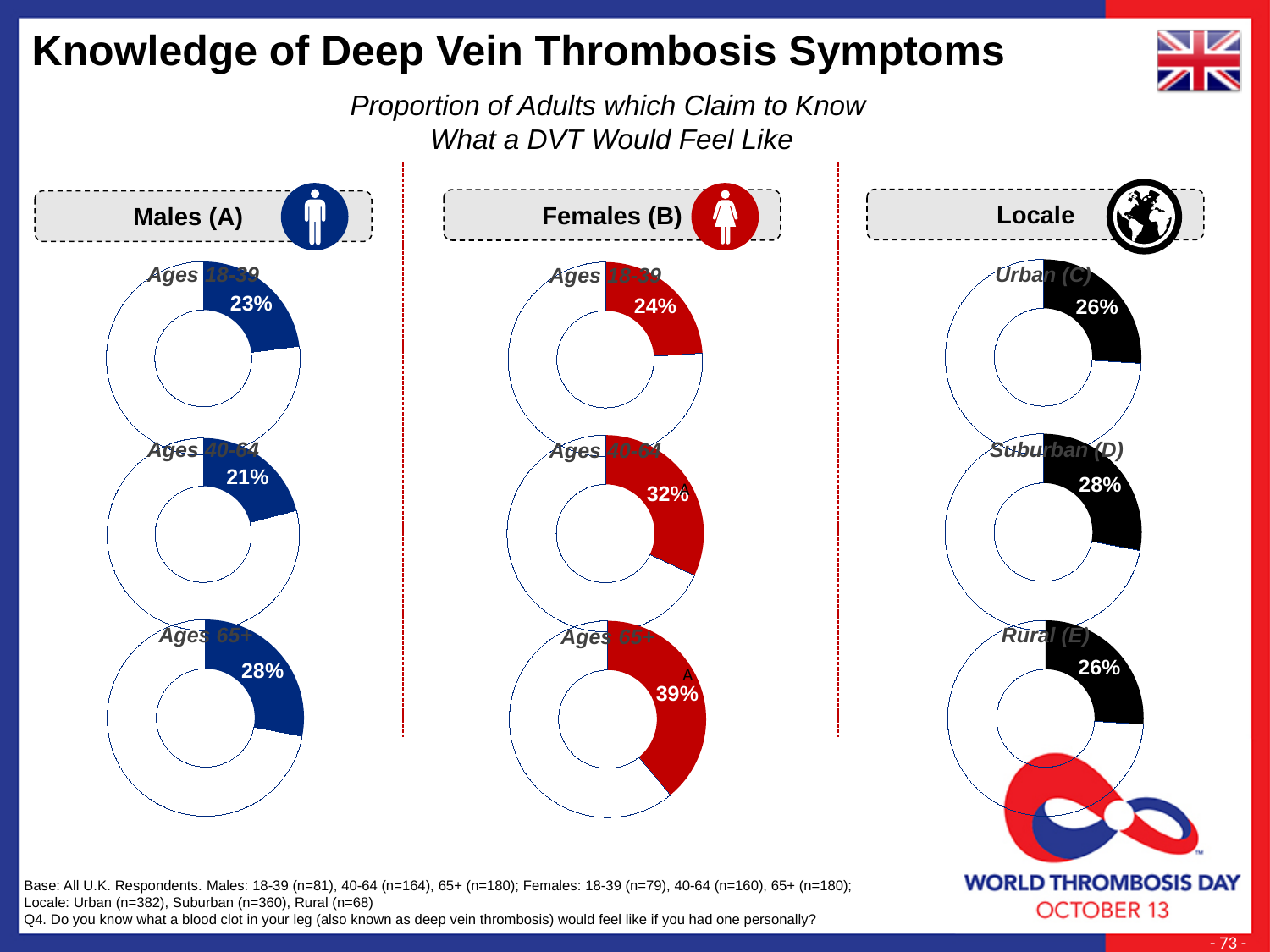
What colour is the filled segment in the Females (B) donut charts? Red Which is larger: the Females (B) Ages 40-64 value or the Males (A) Ages 40-64 value? Females (B) Ages 40-64 Among the three Males (A) donut charts, which age group shows the lowest value? Ages 40-64 What type of chart is used to show the Males (A) Ages 18-39 value? Donut chart What is the difference between the Suburban (D) value and the Rural (E) value in the Locale section? 2% What is the difference between the Females (B) Ages 65+ value and the Males (A) Ages 65+ value? 11% In the Males (A) Ages 18-39 donut chart, what proportion of adults claim to know what a DVT would feel like? 23% In the Females (B) Ages 65+ donut chart, what value is shown? 39% Among the three Females (B) donut charts, which age group shows the highest value? Ages 65+ How many donut charts are shown on the slide in total? 9 In the Locale section, what value is shown in the Suburban (D) donut chart? 28% In the Males (A) Ages 40-64 donut chart, what value is shown? 21%